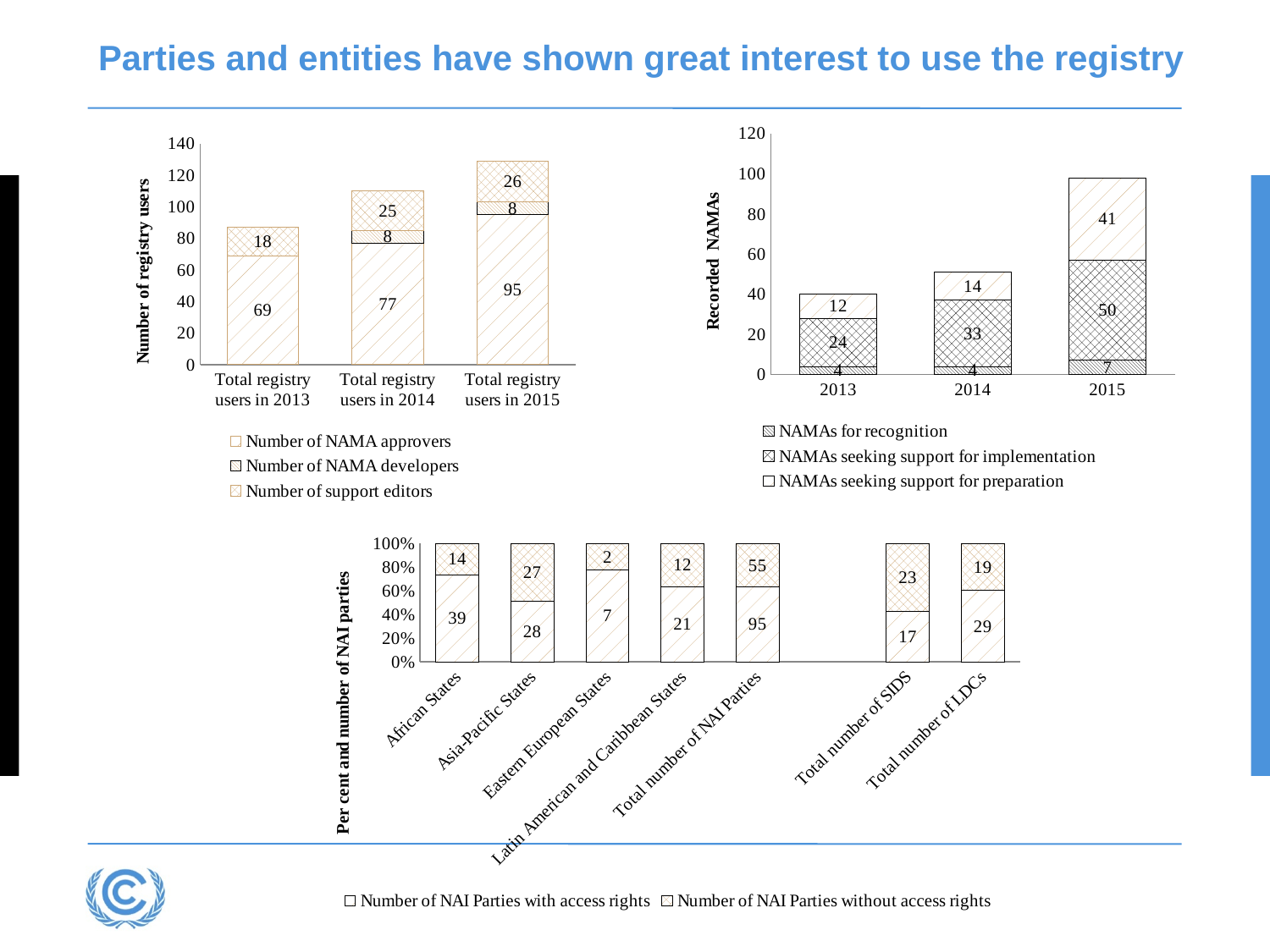
In the top-right chart (Recorded NAMAs), what is the total of the stacked bar for 2013? 40 In the top-left chart (Number of registry users), how many series does the legend list? 3 In the top-right chart (Recorded NAMAs), is the total height of the 2015 bar greater or less than 80? greater In the bottom chart (Per cent and number of NAI parties), how many categories are shown on the x axis? 7 In the bottom chart (Per cent and number of NAI parties), which is larger for Total number of SIDS: the number with access rights or the number without access rights? without access rights In the top-left chart (Number of registry users), what is the total of the stacked bar for total registry users in 2014? 110 In the bottom chart (Per cent and number of NAI parties), what is the number of NAI Parties with access rights for African States? 39 In the top-right chart (Recorded NAMAs), what is the difference between NAMAs seeking support for preparation in 2015 and in 2014? 27 In the top-right chart (Recorded NAMAs), what is the value for NAMAs seeking support for preparation in 2014? 14 In the top-left chart (Number of registry users), does the total height of the bars rise or fall from 2013 to 2015? rise In the top-left chart (Number of registry users), what is the value of the bottom segment of the bar for total registry users in 2015? 95 In the top-right chart (Recorded NAMAs), what is the value for NAMAs seeking support for implementation in 2015? 50